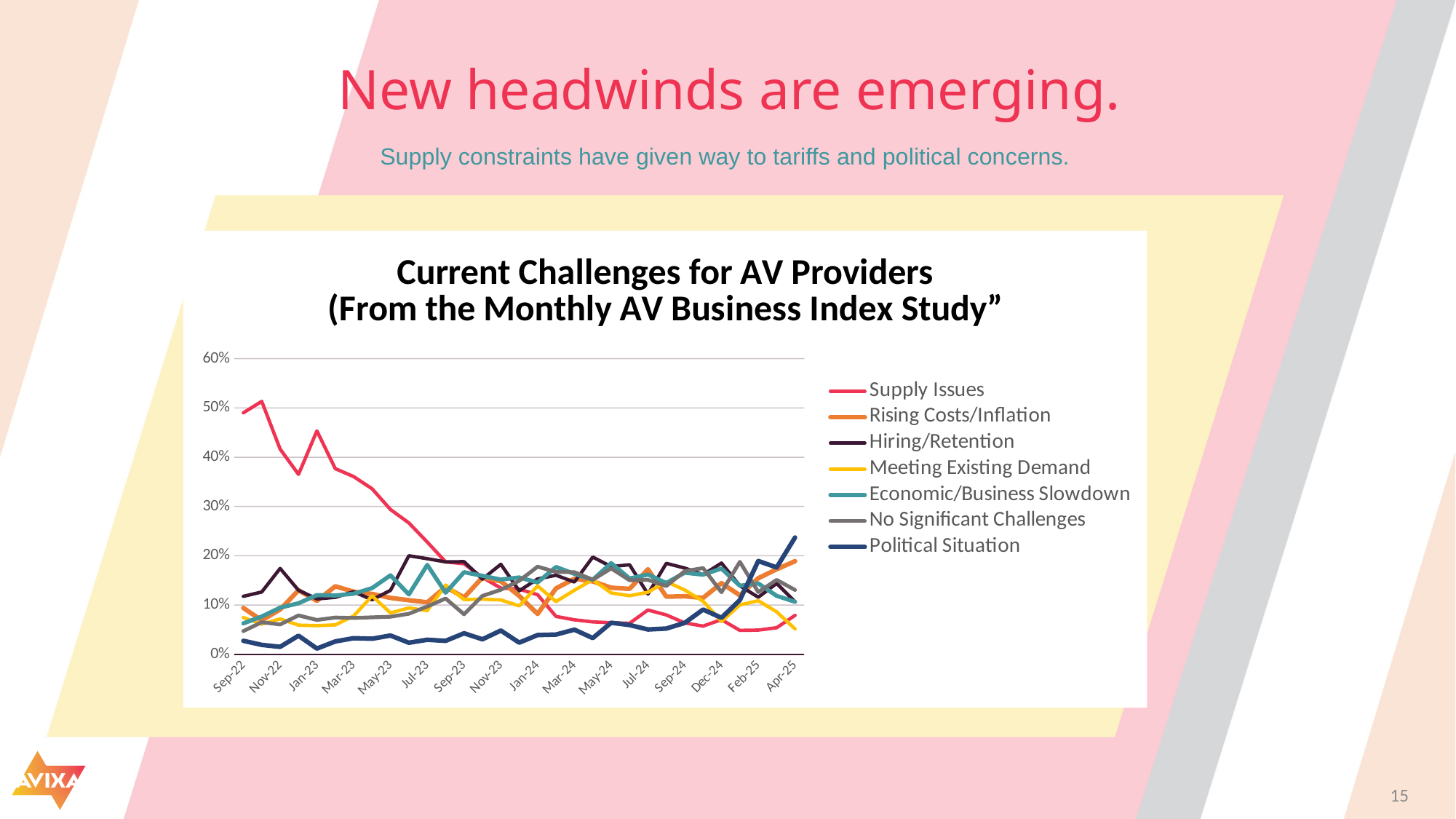
Is the value for Supply Issues at Sep-22 greater or less than 40%? greater Does the Political Situation line rise or fall from Sep-22 to Apr-25? rise Which series is highest at Apr-25? Political Situation At Sep-22, which is larger: Supply Issues or Political Situation? Supply Issues What is the title of the chart? Current Challenges for AV Providers (From the Monthly AV Business Index Study" Is the value for Political Situation at Sep-22 greater or less than 10%? less Is the value for Political Situation at Apr-25 greater or less than 20%? greater How many series does the legend list? 7 Which series is highest at Sep-22? Supply Issues Does the Supply Issues line rise or fall from Sep-22 to Apr-25? fall What kind of chart is shown on the slide? line chart